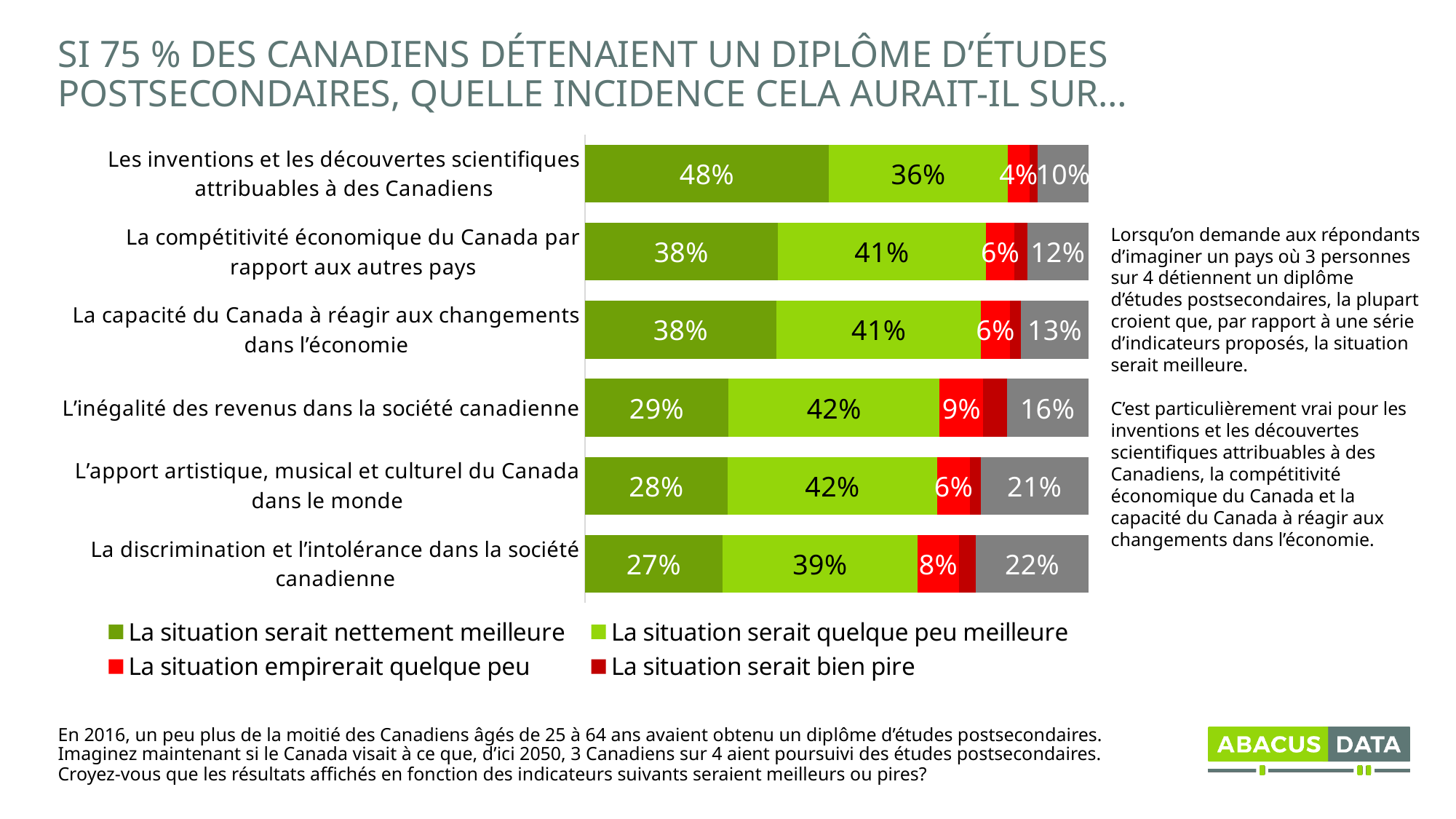
What is the difference in percentage points between the "nettement meilleure" share for inventions and scientific discoveries (48%) and for discrimination and intolerance (27%)? 21 percentage points What is the value of "La situation serait quelque peu meilleure" for income inequality in Canadian society ("L'inégalité des revenus dans la société canadienne")? 42% Which indicator has the highest share of respondents saying the situation would be clearly better ("nettement meilleure")? Les inventions et les découvertes scientifiques attribuables à des Canadiens What colour represents "La situation serait bien pire" in the legend? Dark red How many series does the legend list? 4 Which indicator has the lowest share of respondents saying the situation would be clearly better ("nettement meilleure")? La discrimination et l'intolérance dans la société canadienne What percentage of respondents said the situation would be clearly better ("nettement meilleure") for inventions and scientific discoveries attributable to Canadians? 48% What type of chart is shown on the slide? Stacked bar chart What percentage said the situation would get somewhat worse ("empirerait quelque peu") for discrimination and intolerance in Canadian society? 8% Which has a larger "La situation serait quelque peu meilleure" share: Canada's economic competitiveness or discrimination and intolerance in Canadian society? La compétitivité économique du Canada par rapport aux autres pays What is the value of the grey segment for "L'apport artistique, musical et culturel du Canada dans le monde"? 21% How many indicators (categories) are shown in the chart? 6